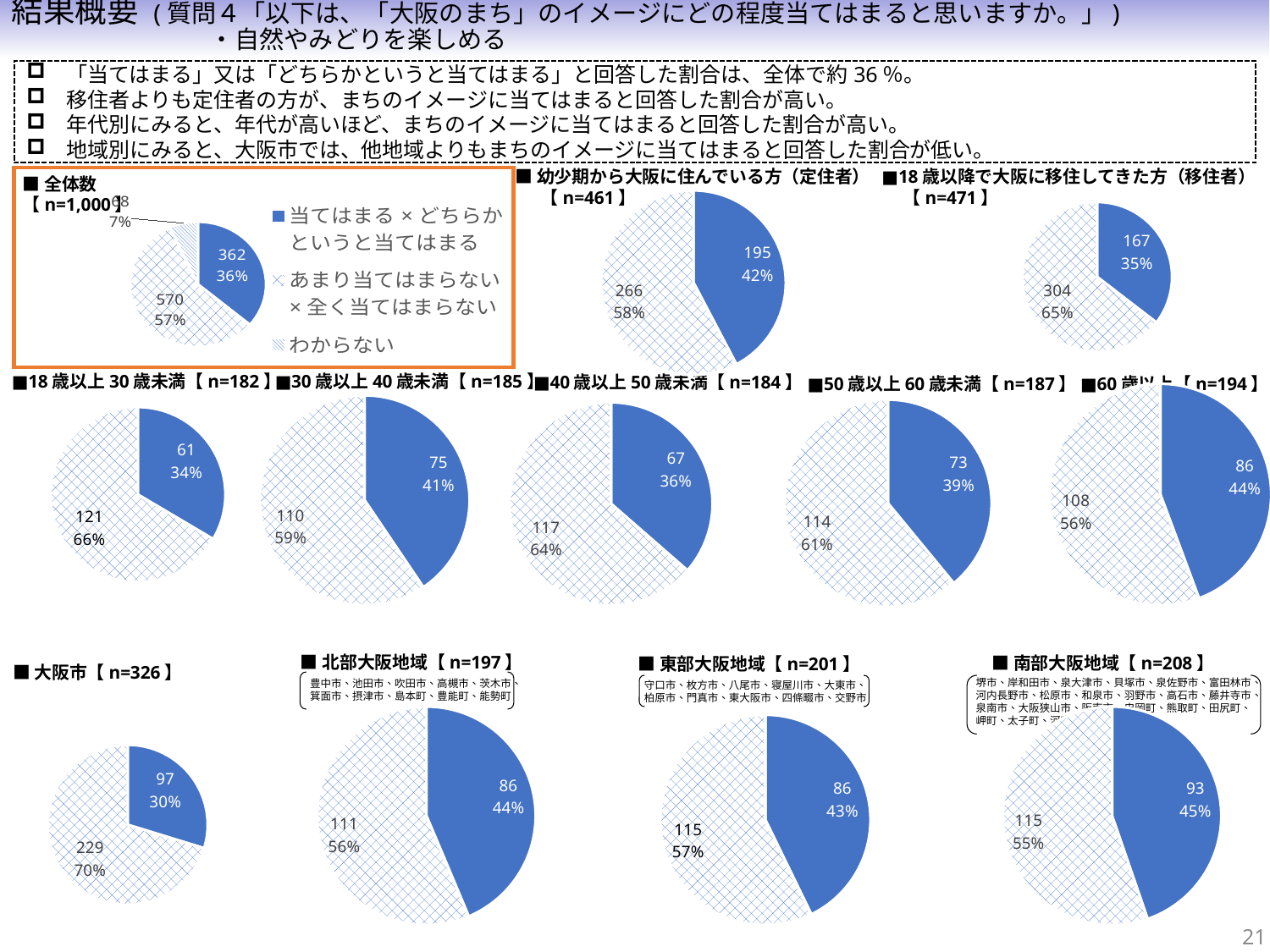
Among the four regional pie charts (大阪市, 北部大阪地域, 東部大阪地域, 南部大阪地域), which has the lowest blue-slice percentage? 大阪市【n=326】 In the 幼少期から大阪に住んでいる方（定住者）【n=461】 pie chart, what percentage is shown for the blue slice? 42% How many entries does the legend next to the 全体数 pie chart list? 3 In the 大阪市【n=326】 pie chart, what percentage is shown for the hatched (non-blue) slice? 70% Among the five age-group pie charts (18歳以上30歳未満 to 60歳以上), which has the highest blue-slice percentage? 60歳以上【n=194】 In the 18歳以上30歳未満【n=182】 pie chart, what is the difference between the two slice counts (121 and 61)? 60 In the 南部大阪地域【n=208】 pie chart, what count is shown for the blue slice? 93 What kind of chart is used for the 幼少期から大阪に住んでいる方（定住者）【n=461】 data? pie chart In the 18歳以降で大阪に移住してきた方（移住者）【n=471】 pie chart, what count is shown for the blue slice? 167 In the 全体数【n=1,000】 pie chart, what percentage is shown for the 当てはまる×どちらかというと当てはまる slice? 36% Which has the larger blue-slice percentage: the 定住者【n=461】 pie chart or the 移住者【n=471】 pie chart? 定住者【n=461】 In the 全体数【n=1,000】 pie chart, what count is shown for the あまり当てはまらない×全く当てはまらない slice? 570